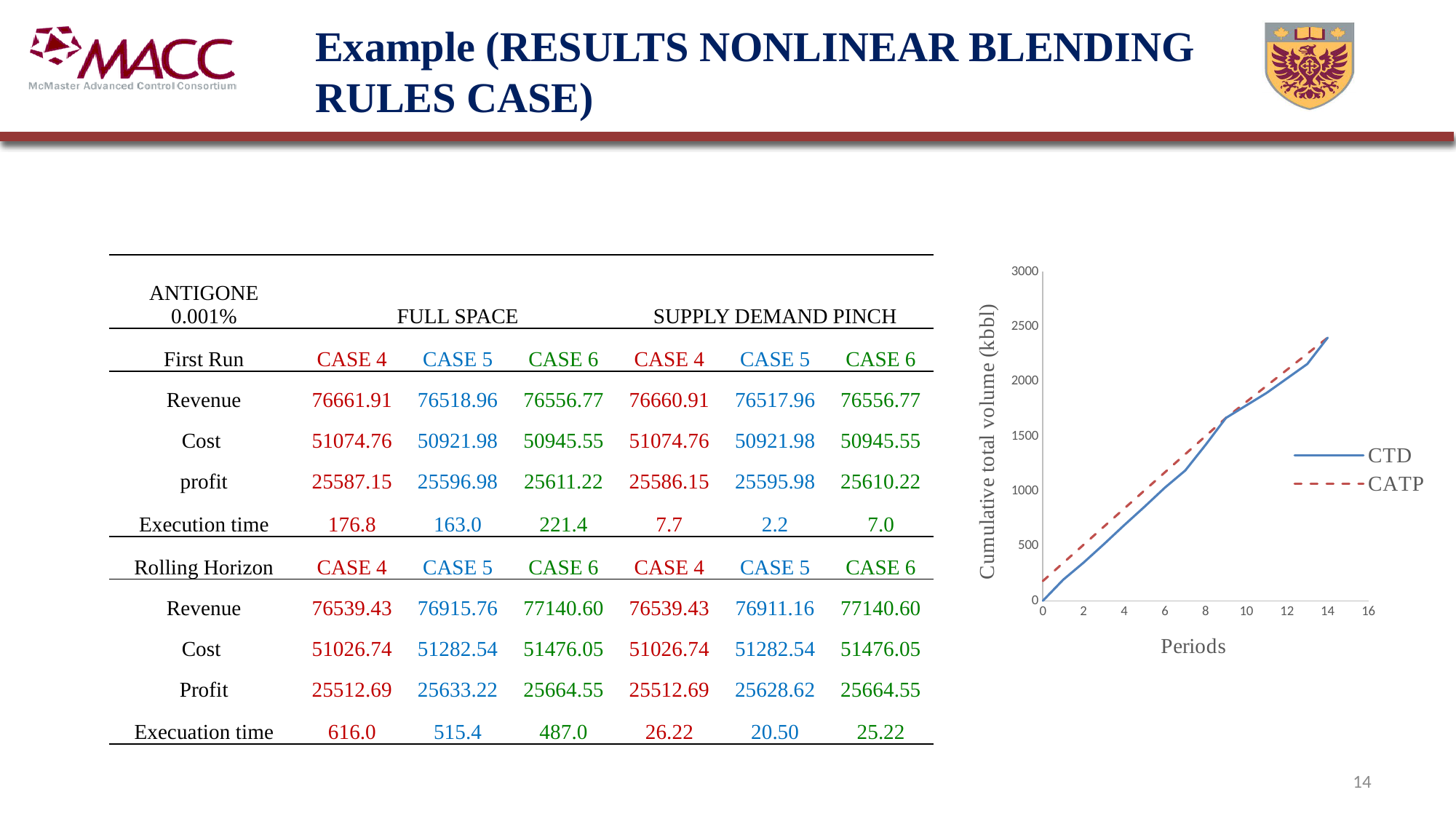
At which period does the CTD series reach its highest value? 14 What kind of chart is shown on the right of the slide? line chart Is the CTD value at period 4 greater or less than 1000? less At period 4, which series has the larger value, CTD or CATP? CATP Is the CATP value at period 8 greater or less than 1000? greater Do the CTD values rise or fall as the periods increase? rise Is the CTD value at period 14 greater or less than 2000? greater What are the two series named in the chart legend? CTD and CATP What is the label of the vertical axis of the chart? Cumulative total volume (kbbl) How many series does the legend of the chart list? 2 At period 0, which series has the larger value, CTD or CATP? CATP